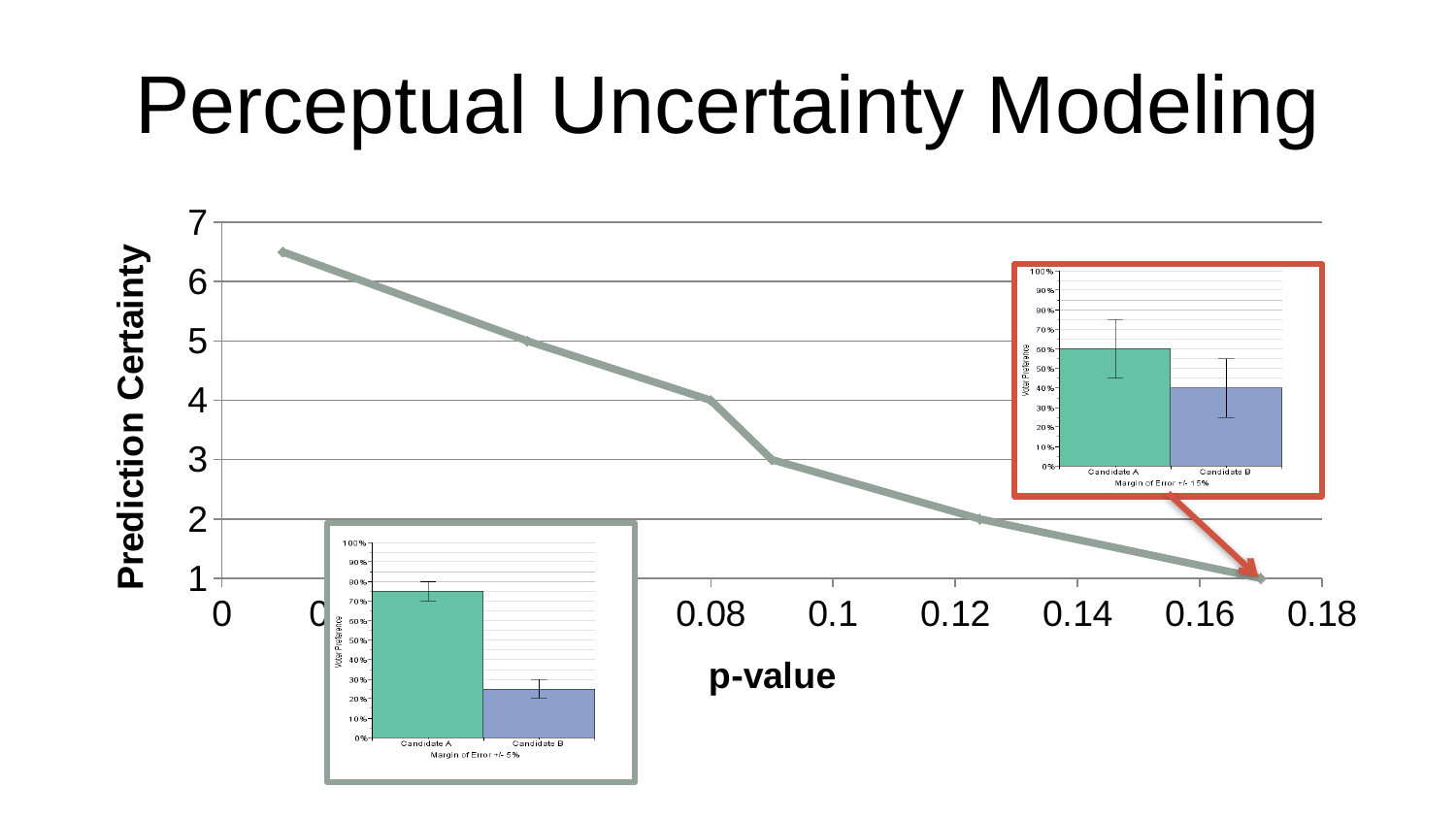
How many data points are plotted on the main line chart? 6 What is the x-axis label of the main line chart? p-value What is the y-axis label of the main line chart? Prediction Certainty What kind of chart is the main chart on the slide (Prediction Certainty vs p-value)? line chart How many categories are shown in the inset chart 'Margin of Error +/- 15%'? 2 In the main line chart, is the Prediction Certainty at the rightmost point (p-value about 0.17) greater or less than 2? less In the main line chart, is the Prediction Certainty at the leftmost point greater or less than 6? greater In the main line chart, is the Prediction Certainty at p-value 0.08 greater or less than 3? greater What kind of chart is the inset chart titled 'Margin of Error +/- 5%'? bar chart In the main line chart, does Prediction Certainty rise or fall as p-value increases? fall In the inset chart 'Margin of Error +/- 5%', which candidate has the larger voter preference, Candidate A or Candidate B? Candidate A